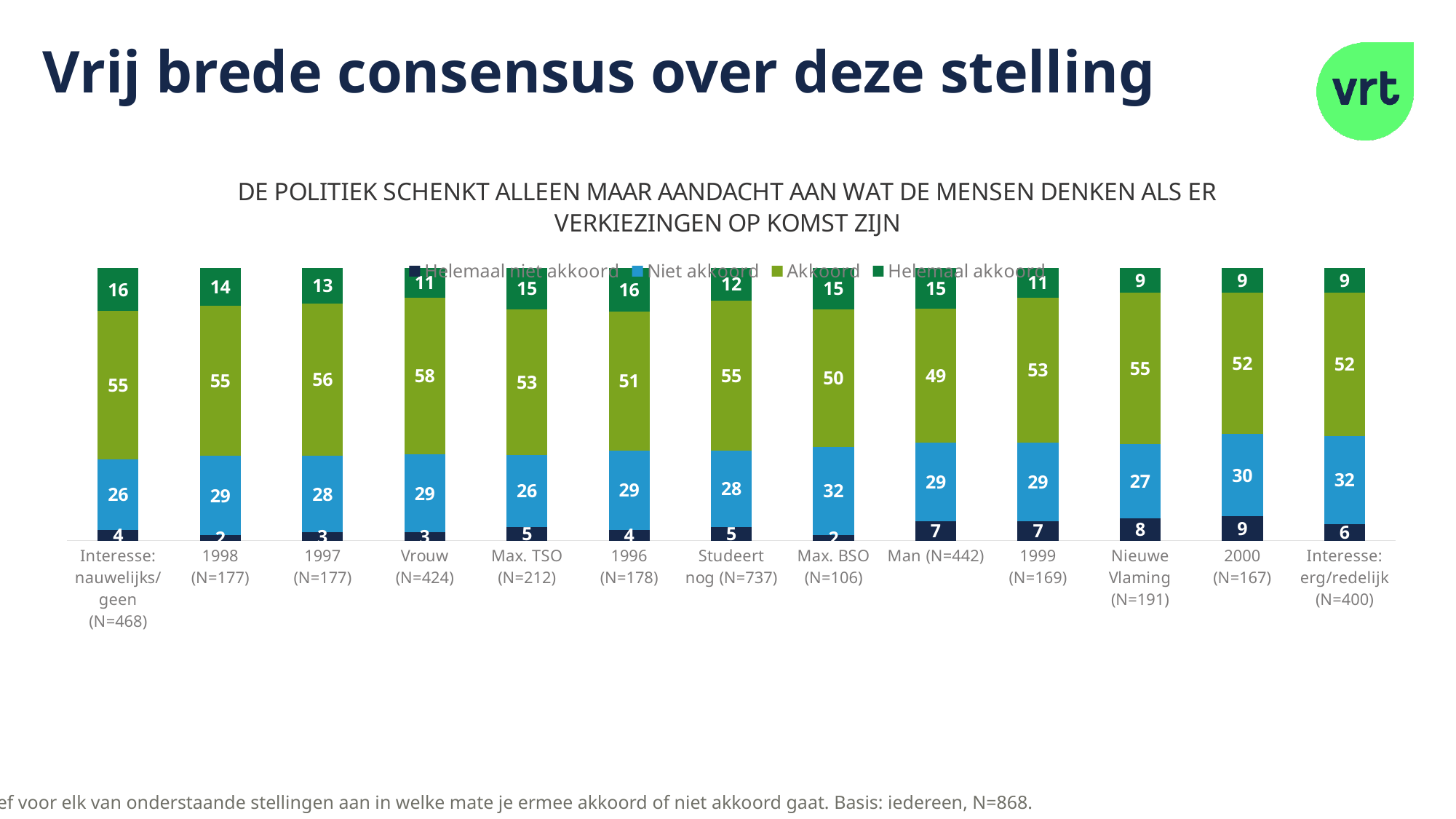
What is the 'Helemaal akkoord' value for 1998 (N=177)? 14 How many categories are shown on the x axis? 13 What is the 'Niet akkoord' value for Max. BSO (N=106)? 32 Which category has the highest 'Akkoord' value? Vrouw (N=424) What is the difference between the 'Akkoord' values for Vrouw (N=424) and Man (N=442)? 9 What is the 'Akkoord' value for Vrouw (N=424)? 58 What kind of chart is shown on the slide? Stacked bar chart What is the total of the stacked bar for 1998 (N=177)? 100 Which category has the lowest 'Akkoord' value? Man (N=442) Which category has the highest 'Helemaal niet akkoord' value? 2000 (N=167) How many series does the legend list? 4 Which is larger: the 'Helemaal akkoord' value for 1996 (N=178) or for 2000 (N=167)? 1996 (N=178)